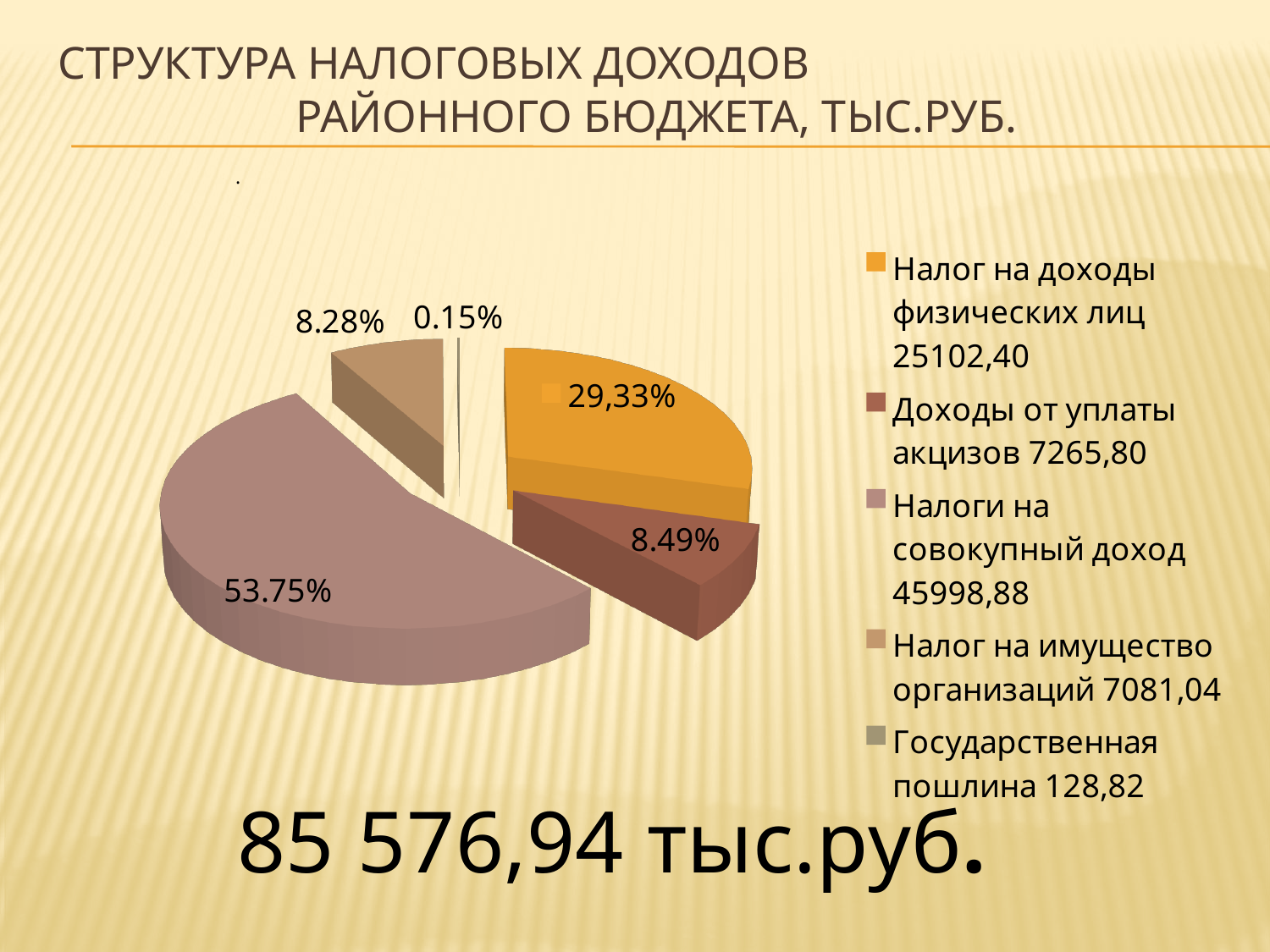
How many slices does the pie chart have? 5 Which category has the largest slice of the pie? Налоги на совокупный доход Which category has the smallest slice of the pie? Государственная пошлина What percentage is shown for "Государственная пошлина"? 0.15% What type of chart is shown on the slide? pie chart How many entries does the legend list? 5 What is the difference in percentage points between the shares of "Налоги на совокупный доход" and "Налог на доходы физических лиц"? 24.42 Which is larger: the share for "Доходы от уплаты акцизов" or for "Налог на имущество организаций"? Доходы от уплаты акцизов According to the legend, what amount in тыс.руб. is given for "Налог на имущество организаций"? 7081,04 What percentage is shown for "Доходы от уплаты акцизов"? 8.49% What percentage is shown for "Налог на доходы физических лиц"? 29,33% What share of the pie does "Налоги на совокупный доход" have? 53.75%